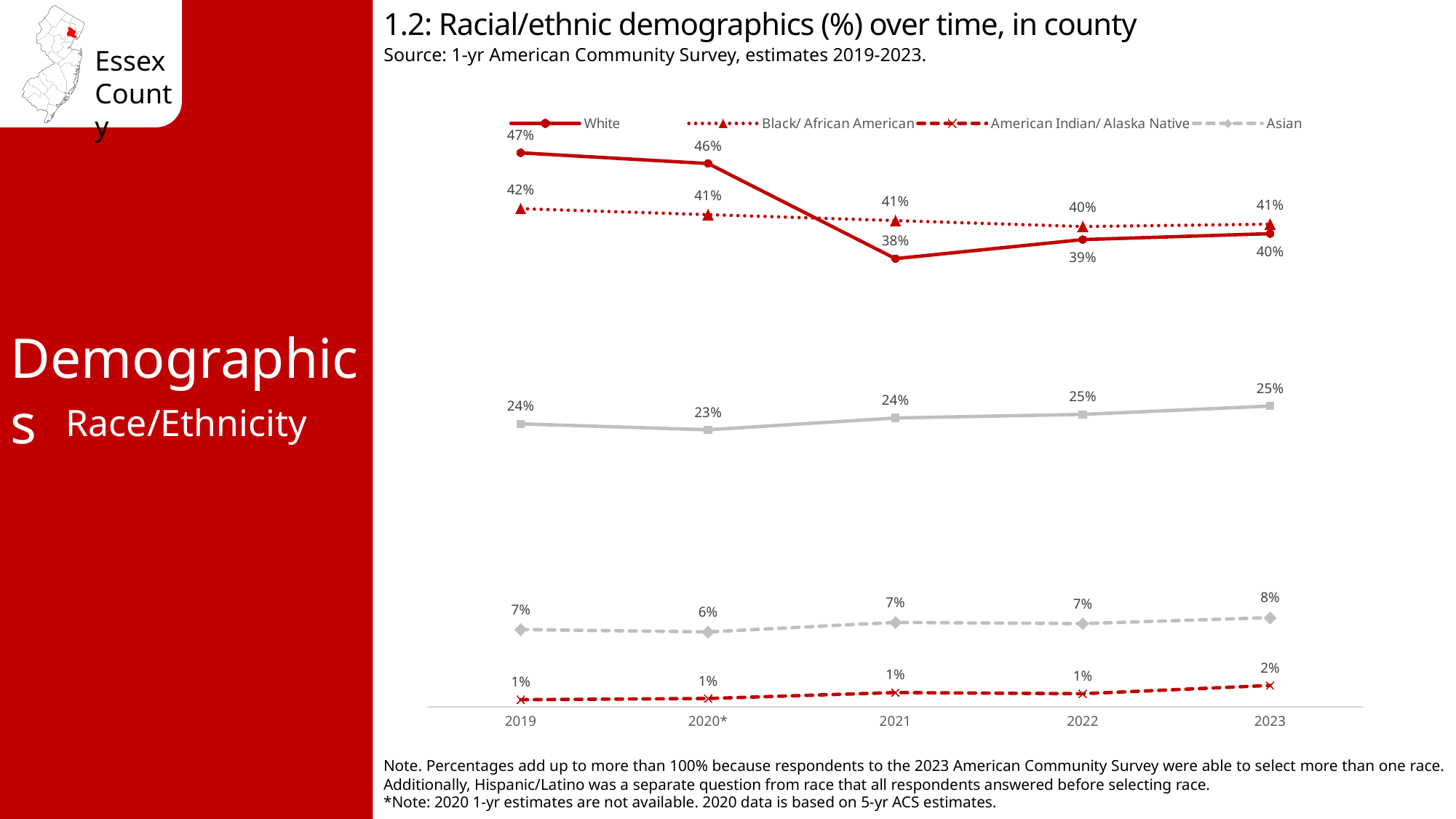
What type of chart is shown on the slide? line chart In which year was the White percentage lowest? 2021 Did the Asian percentage rise or fall from 2019 to 2023? rise What was the White percentage in 2019? 47% How many years are shown on the x axis? 5 Which was larger in 2021, the White percentage or the Black/ African American percentage? Black/ African American What was the Asian percentage in 2020*? 6% What was the Black/ African American percentage in 2023? 41% What was the American Indian/ Alaska Native percentage in 2023? 2% What is the source cited for the chart? 1-yr American Community Survey, estimates 2019-2023 By how many percentage points did the White percentage fall from 2020* to 2021? 8 In which year was the White percentage highest? 2019